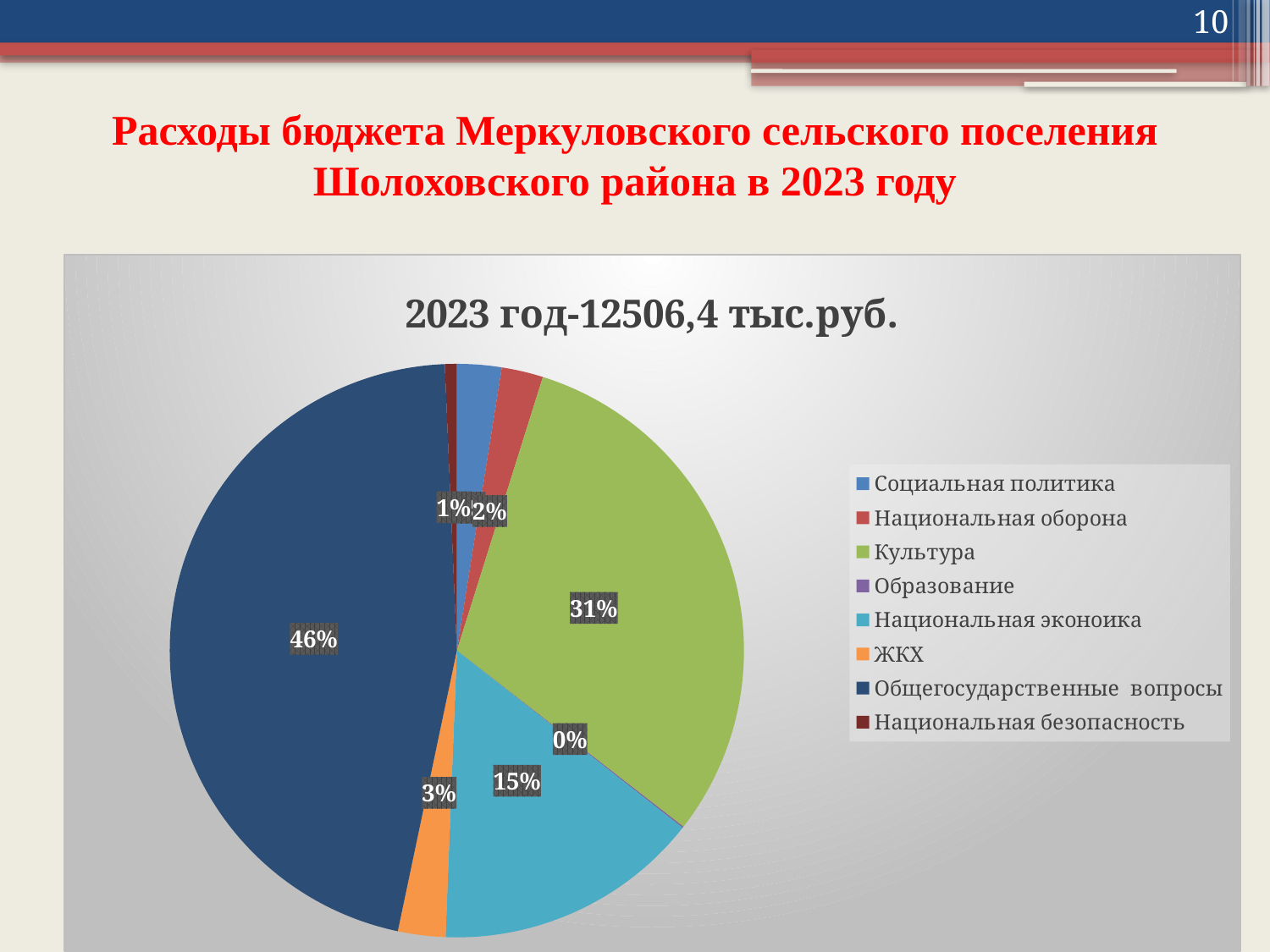
What kind of chart is shown on the slide? pie chart How many categories does the legend list? 8 What share of the pie does Национальная экономика take? 15% What share of the pie does Общегосударственные вопросы take? 46% Which category has the smallest share of the pie? Образование What share of the pie does Образование take? 0% By how many percentage points does the share for Общегосударственные вопросы exceed the share for Культура? 15 percentage points Which category has the largest share of the pie? Общегосударственные вопросы What is the title of the chart? 2023 год-12506,4 тыс.руб. Which is larger: the share for Культура or the share for Национальная экономика? Культура